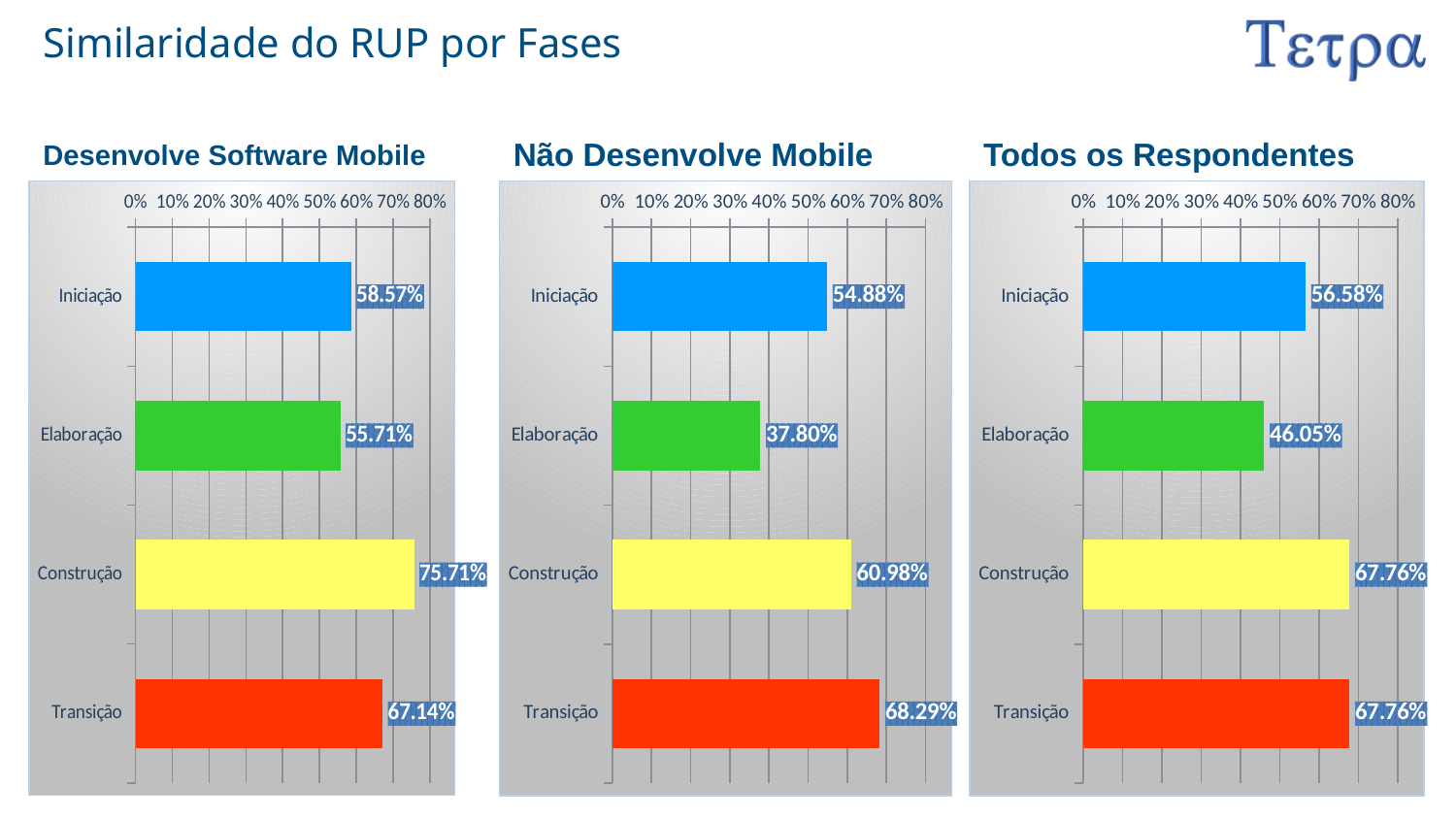
In the 'Não Desenvolve Mobile' chart, which phase has the highest value? Transição How many phases are shown in the 'Desenvolve Software Mobile' chart? 4 In the 'Desenvolve Software Mobile' chart, what is the difference between the values for Construção and Transição? 8.57 percentage points In the 'Todos os Respondentes' chart, which phase has the lowest value? Elaboração In the 'Desenvolve Software Mobile' chart, which phase has the highest value? Construção What kind of chart is the 'Todos os Respondentes' chart? Bar chart In the 'Não Desenvolve Mobile' chart, what is the difference between the values for Transição and Elaboração? 30.49 percentage points In the 'Não Desenvolve Mobile' chart, which phase has the lowest value? Elaboração In the 'Não Desenvolve Mobile' chart, what is the value for Elaboração? 37.80% In the 'Desenvolve Software Mobile' chart, what is the value for Construção? 75.71% In the 'Todos os Respondentes' chart, which is larger, the value for Iniciação or the value for Elaboração? Iniciação In the 'Todos os Respondentes' chart, what is the value for Iniciação? 56.58%